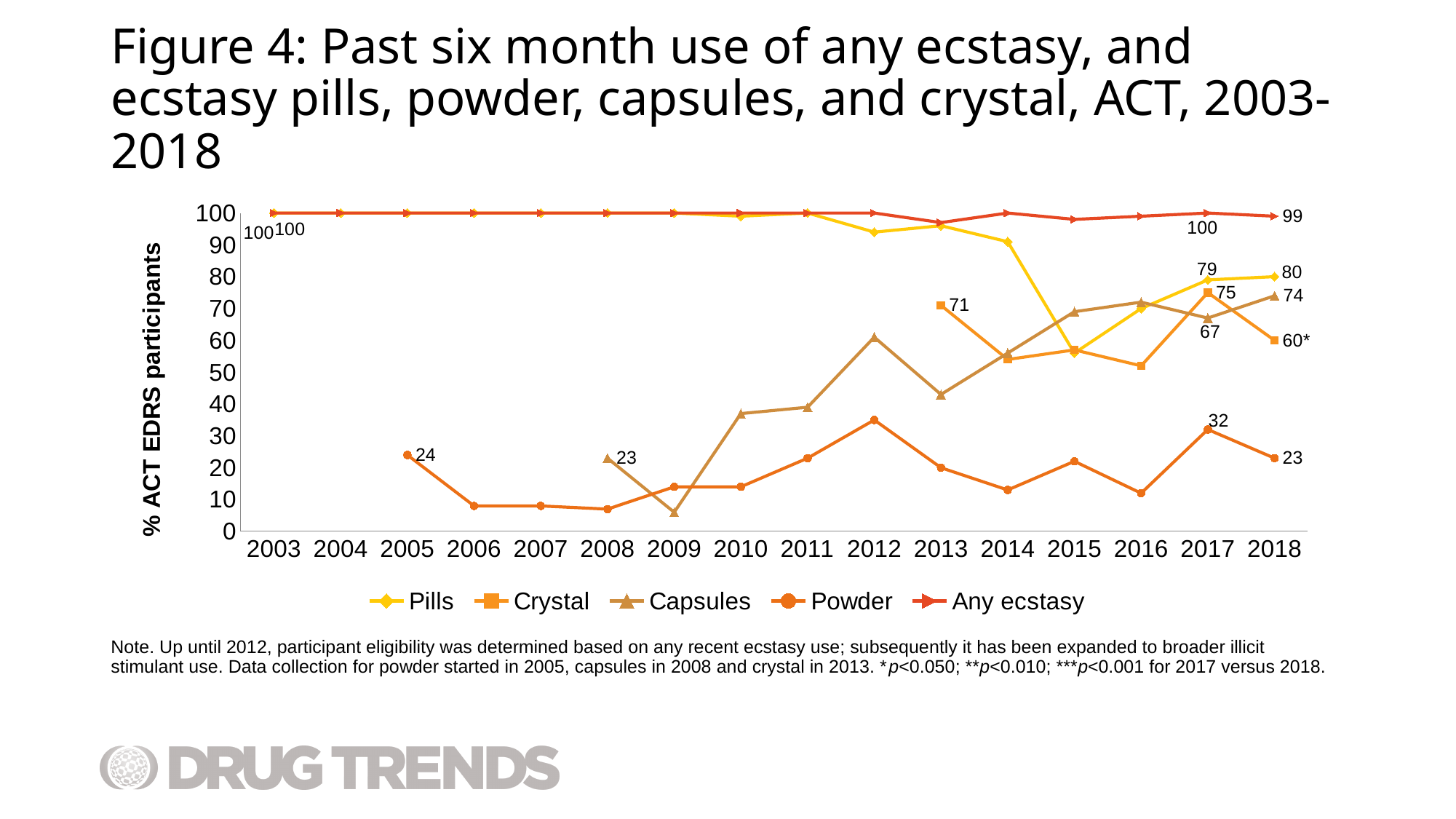
How many series does the legend list? 5 What kind of chart is shown on the slide? line chart Which series has the lowest value in 2018? Powder How many years are shown on the x axis? 16 What is the difference between the Pills values in 2018 and 2017? 1 Is the value for Capsules in 2012 greater or less than 50? greater What is the value for Powder in 2017? 32 In 2018, which is larger: Capsules or Crystal? Capsules What is the value for Any ecstasy in 2018? 99 What is the difference between the Powder values in 2017 and 2018? 9 What is the value for Pills in 2018? 80 What is the value for Crystal in 2013? 71